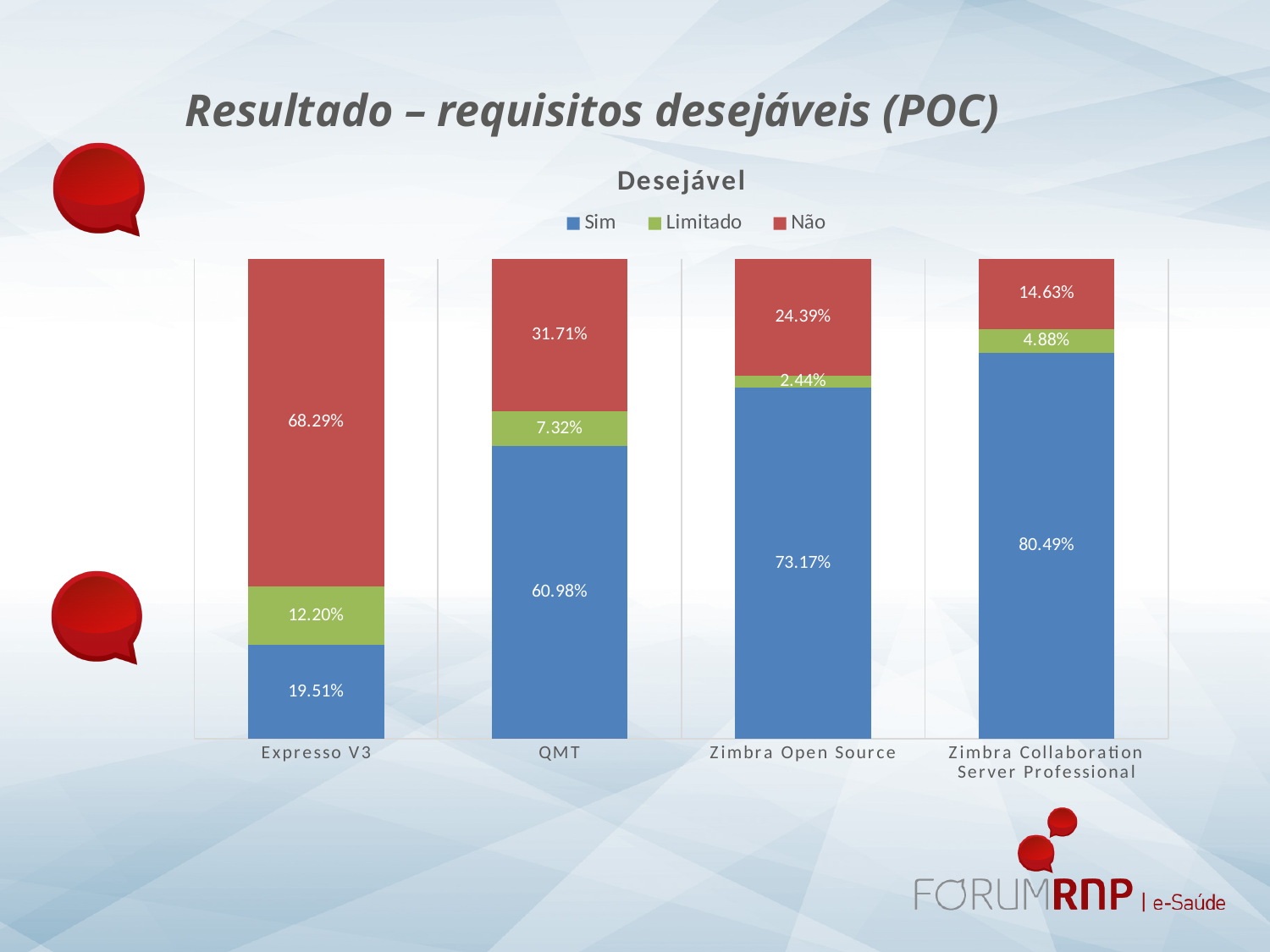
How many series does the legend list? 3 What is the value of Não for QMT? 31.71% How many categories are shown on the x axis? 4 Which category has the lowest value for Não? Zimbra Collaboration Server Professional What is the value of Sim for Expresso V3? 19.51% What is the value of Sim for Zimbra Collaboration Server Professional? 80.49% Which category has the highest value for Sim? Zimbra Collaboration Server Professional What is the title of the chart? Desejável What is the value of Limitado for Zimbra Open Source? 2.44% What is the difference between the Não value for Expresso V3 and the Não value for QMT? 36.58% What kind of chart is shown on the slide? Stacked bar chart Which is larger: the Limitado value for Expresso V3 or the Limitado value for QMT? Expresso V3